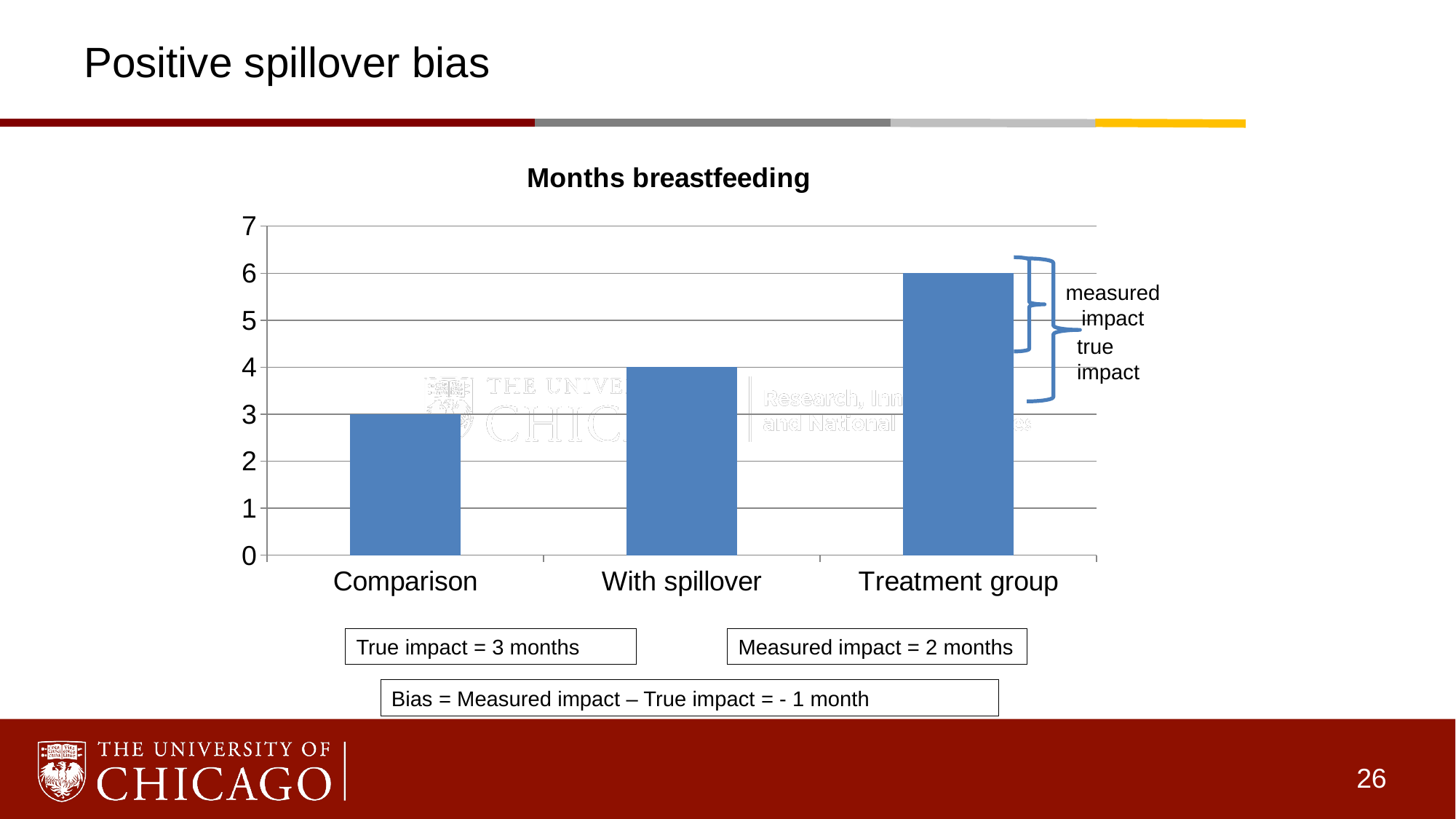
Which category has the highest value in the Months breastfeeding chart? Treatment group What kind of chart is shown on the slide? bar chart What is the title of the chart? Months breastfeeding What is the value for Comparison in the Months breastfeeding chart? 3 What is the difference between the Treatment group and Comparison values? 3 What is the value for Treatment group in the Months breastfeeding chart? 6 Is the value for Treatment group greater or less than 5? greater Which is larger, the value for With spillover or the value for Comparison? With spillover What is the difference between the Treatment group and With spillover values? 2 Which category has the lowest value in the Months breastfeeding chart? Comparison How many categories are shown on the x axis of the chart? 3 What is the value for With spillover in the Months breastfeeding chart? 4